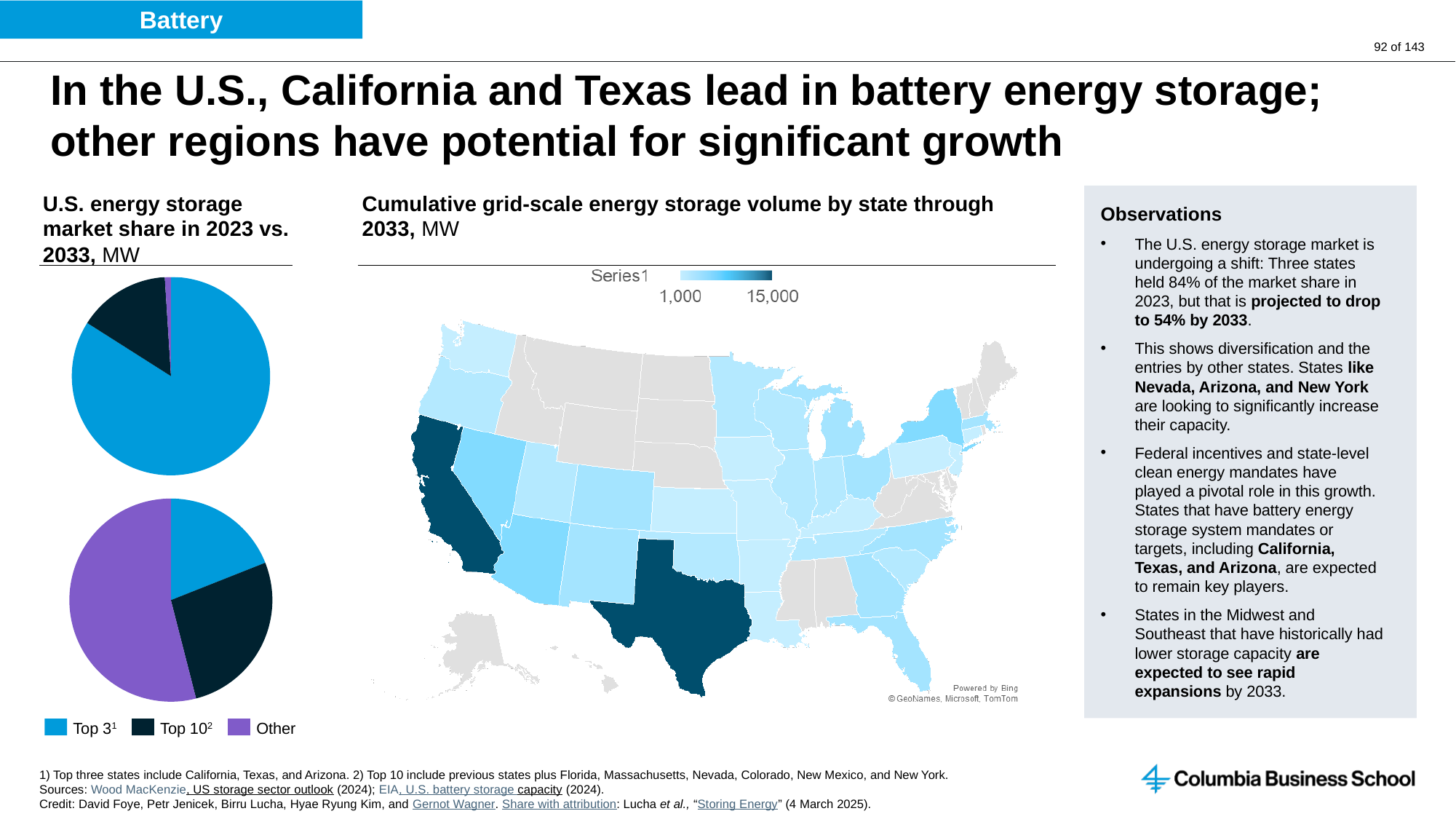
How many slices does the top pie chart (U.S. energy storage market share) have? 3 In the top pie chart (U.S. energy storage market share), which category has the largest share? Top 3 In the top pie chart (U.S. energy storage market share), which is larger: the Top 3 slice or the Top 10 slice? Top 3 In the bottom pie chart (U.S. energy storage market share), which category has the smallest share? Top 3 What are the two values labelled on the colour scale of the map chart 'Cumulative grid-scale energy storage volume by state through 2033'? 1,000 and 15,000 In the top pie chart (U.S. energy storage market share), which category has the smallest share? Other In the bottom pie chart (U.S. energy storage market share), which is larger: the Top 3 slice or the Other slice? Other What kind of chart is used to show U.S. energy storage market share in 2023 vs. 2033? Pie chart In the bottom pie chart (U.S. energy storage market share), which category has the largest share? Other What unit is given in the title of the U.S. energy storage market share pie charts? MW How many entries does the legend for the U.S. energy storage market share pie charts list? 3